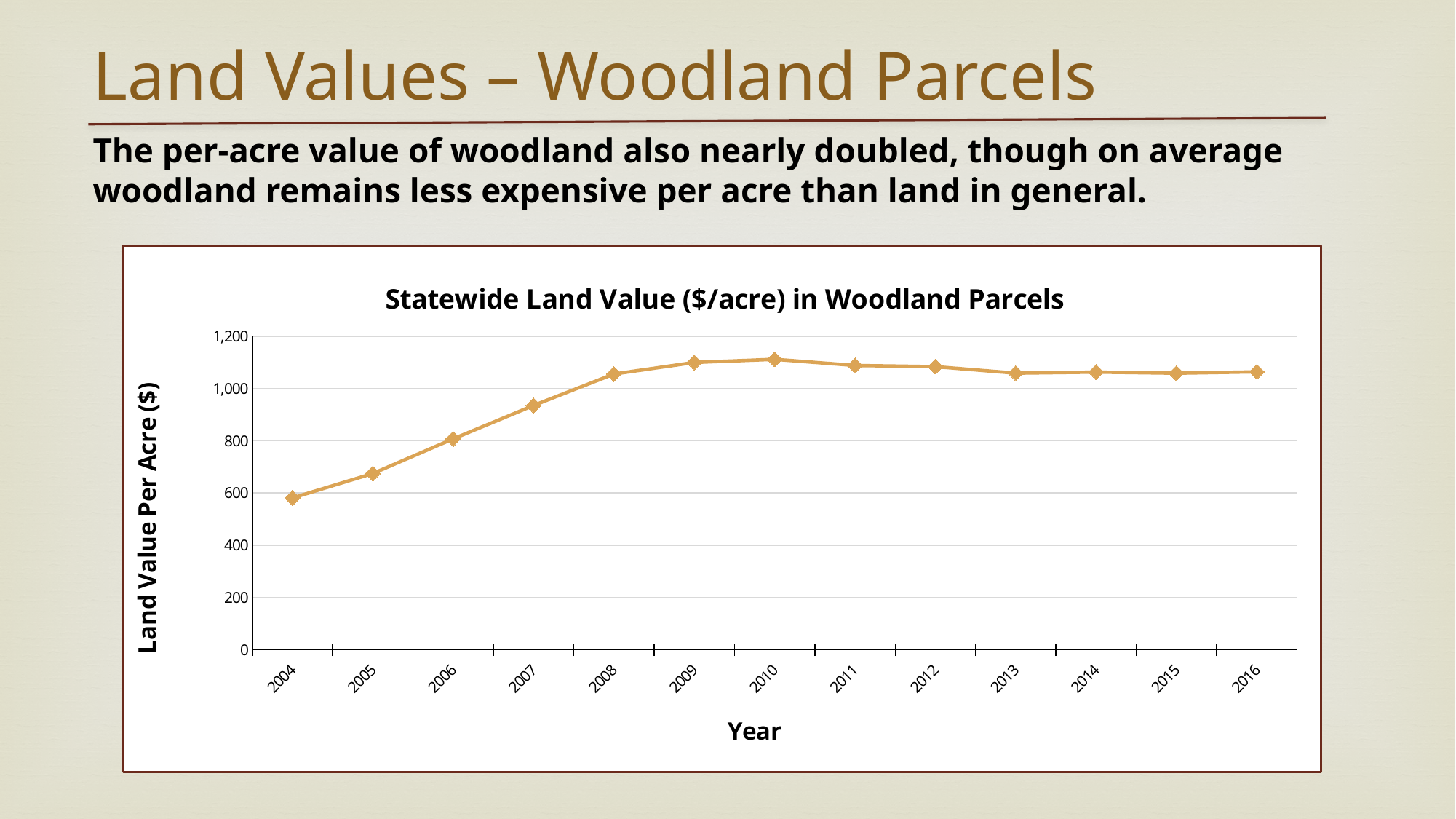
Is the value for 2016 greater or less than 1,000? greater Which year has the lowest land value per acre? 2004 What kind of chart is shown on the slide? line chart Is the value for 2007 greater or less than 1,000? less What is the title of the chart? Statewide Land Value ($/acre) in Woodland Parcels Which year has the larger land value per acre, 2005 or 2008? 2008 Is the value for 2010 greater or less than 1,000? greater Do the land values rise or fall from 2004 to 2010? rise How many years are plotted on the chart? 13 What is the label on the vertical axis of the chart? Land Value Per Acre ($)